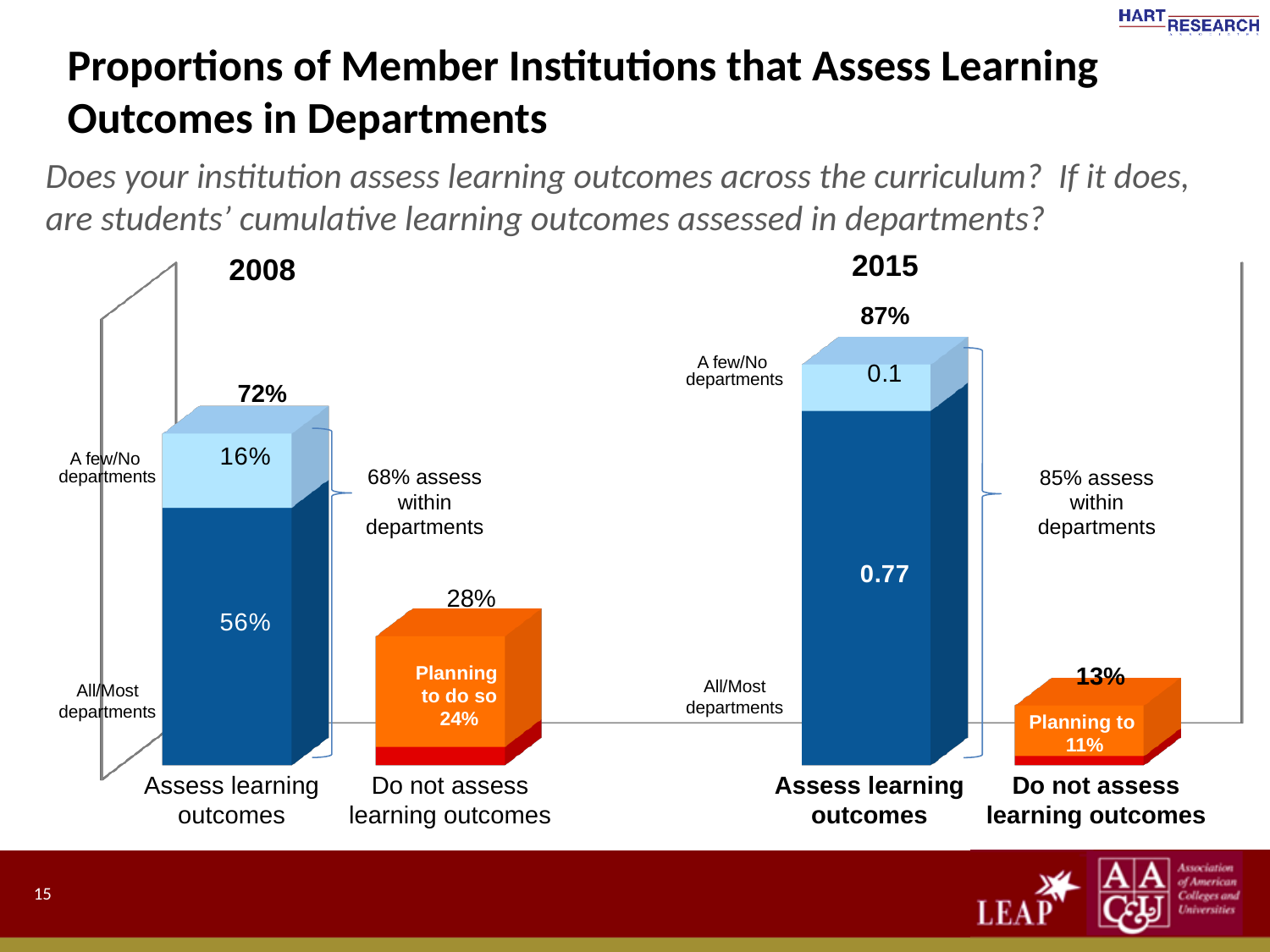
In the 2008 chart, what value is shown for the Planning to do so segment? 24% In the 2008 chart, what value is shown for the A few/No departments segment of the Assess learning outcomes bar? 16% In the 2008 chart, what value is shown for the All/Most departments segment of the Assess learning outcomes bar? 56% Which chart shows the higher total for Assess learning outcomes, 2008 or 2015? 2015 In the 2008 chart, what is the total value shown for Do not assess learning outcomes? 28% In the 2015 chart, what is the total value shown for Do not assess learning outcomes? 13% In the 2008 chart, what is the total value shown for Assess learning outcomes? 72% In the 2008 chart, what is the difference between the All/Most departments segment (56%) and the A few/No departments segment (16%) of the Assess learning outcomes bar? 40% In the 2015 chart, what value is shown for the Planning to segment? 11% In the 2015 chart, what is the total value shown for Assess learning outcomes? 87% In the 2015 chart, what label is printed on the All/Most departments segment of the Assess learning outcomes bar? 0.77 What kind of chart is used on this slide? Stacked bar chart